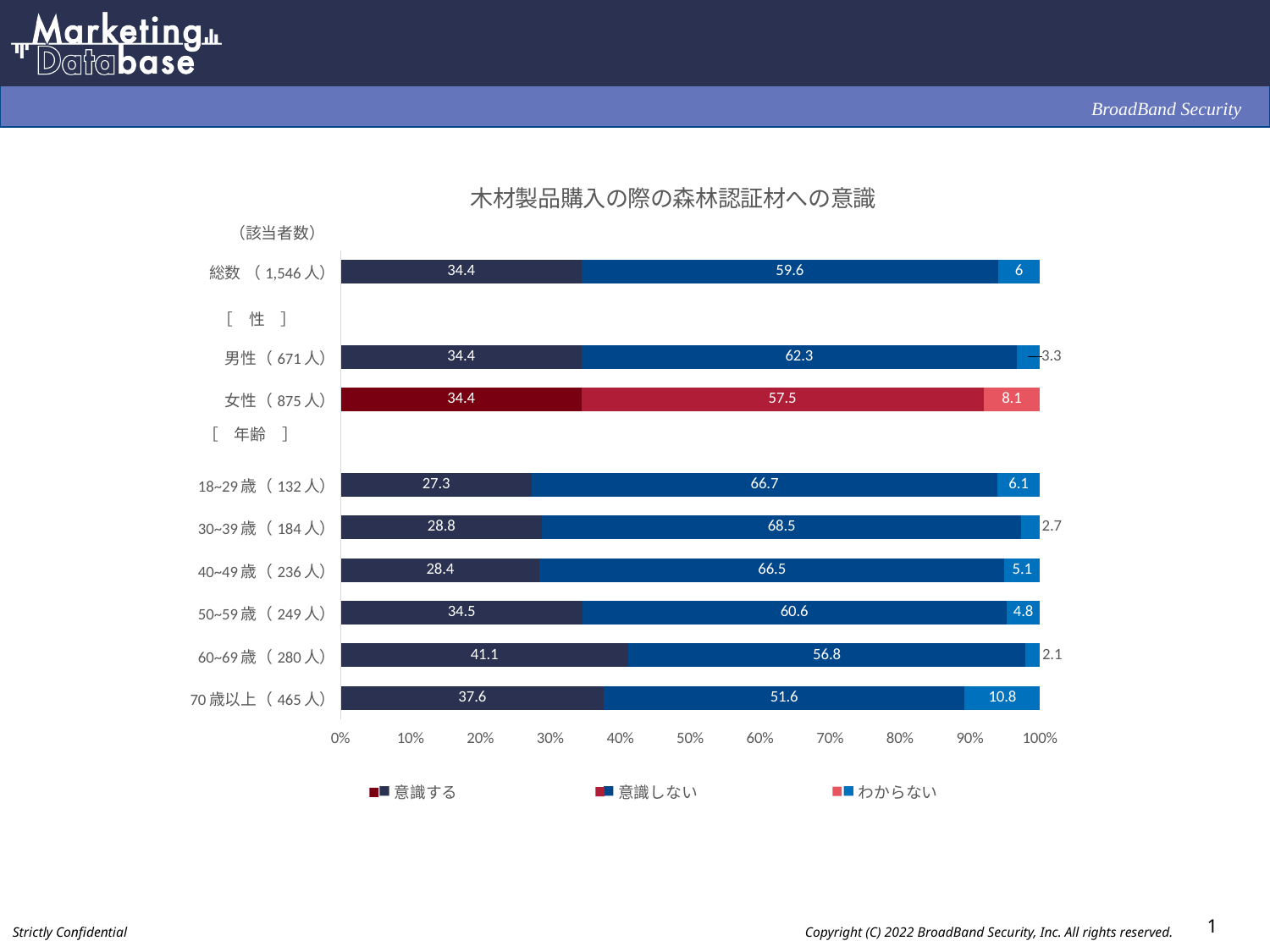
What kind of chart is shown on the slide? Stacked bar chart What is the value of 意識しない for 総数? 59.6 What is the title of the chart? 木材製品購入の際の森林認証材への意識 What is the value of わからない for 70歳以上? 10.8 Among the age groups, which has the lowest value for 意識する? 18~29歳 Which is larger, the わからない value for 男性 or for 女性? 女性 How many series does the legend list? 3 How many categories have bars plotted in the chart? 9 What is the value of 意識する for 60~69歳? 41.1 Among the age groups, which has the highest value for 意識しない? 30~39歳 What is the value of 意識しない for 女性? 57.5 What is the difference between the 意識する values for 60~69歳 and 18~29歳? 13.8